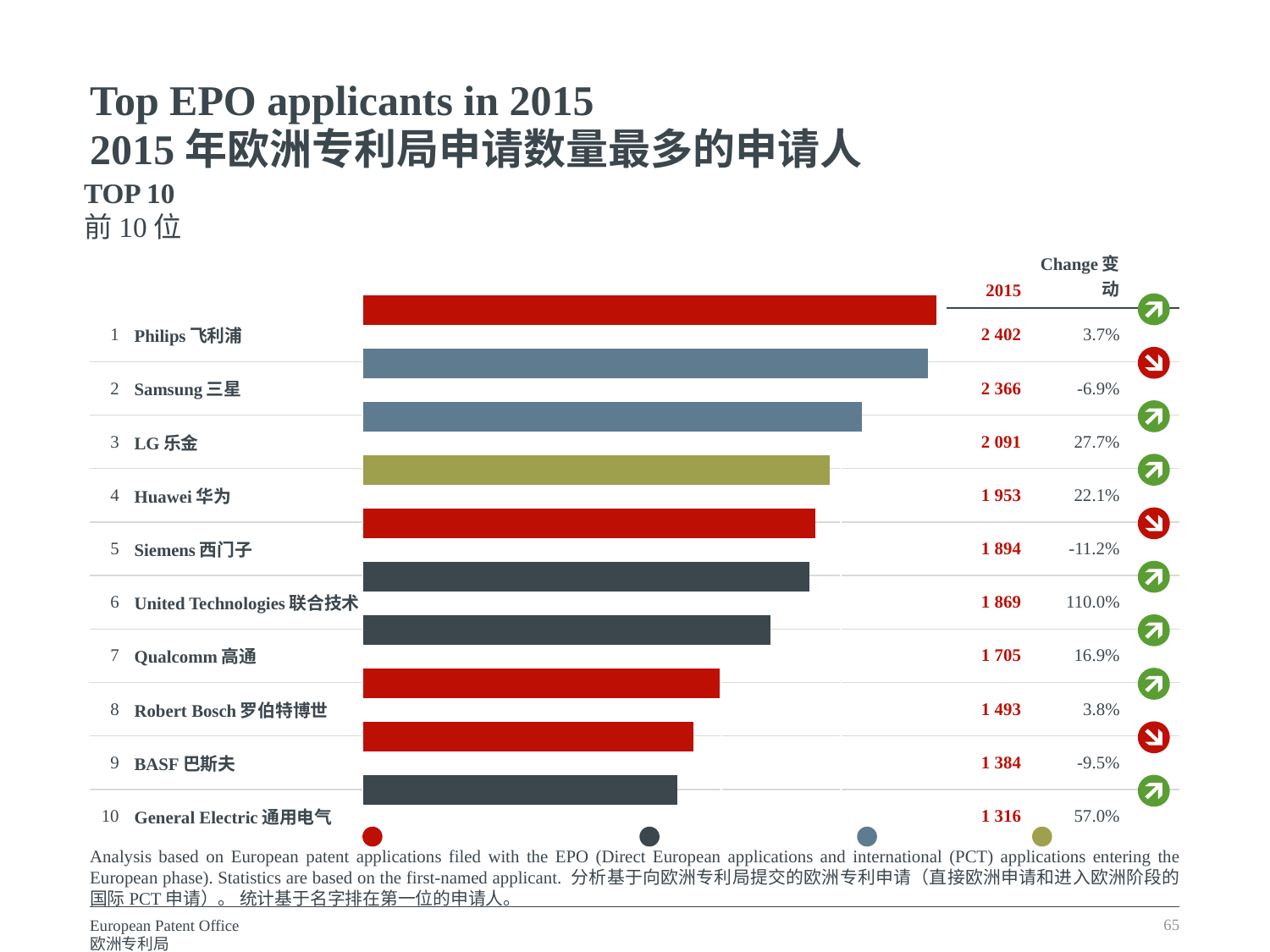
Which has a larger 2015 value, Qualcomm or Robert Bosch? Qualcomm What is the difference between the 2015 values for LG and Huawei? 138 What is the difference between the 2015 values for Philips and Samsung? 36 What is the percentage change shown for Siemens? -11.2% What is the number of EPO applications for Philips in 2015? 2 402 What is the 2015 value shown for Huawei? 1 953 Which applicant has the highest number of applications in 2015? Philips What is the title of the chart on the slide? Top EPO applicants in 2015 Which applicant has the lowest number of applications among the top 10? General Electric What kind of chart is shown on the slide? Bar chart What percentage change is shown for United Technologies? 110.0% How many applicants are shown in the chart? 10